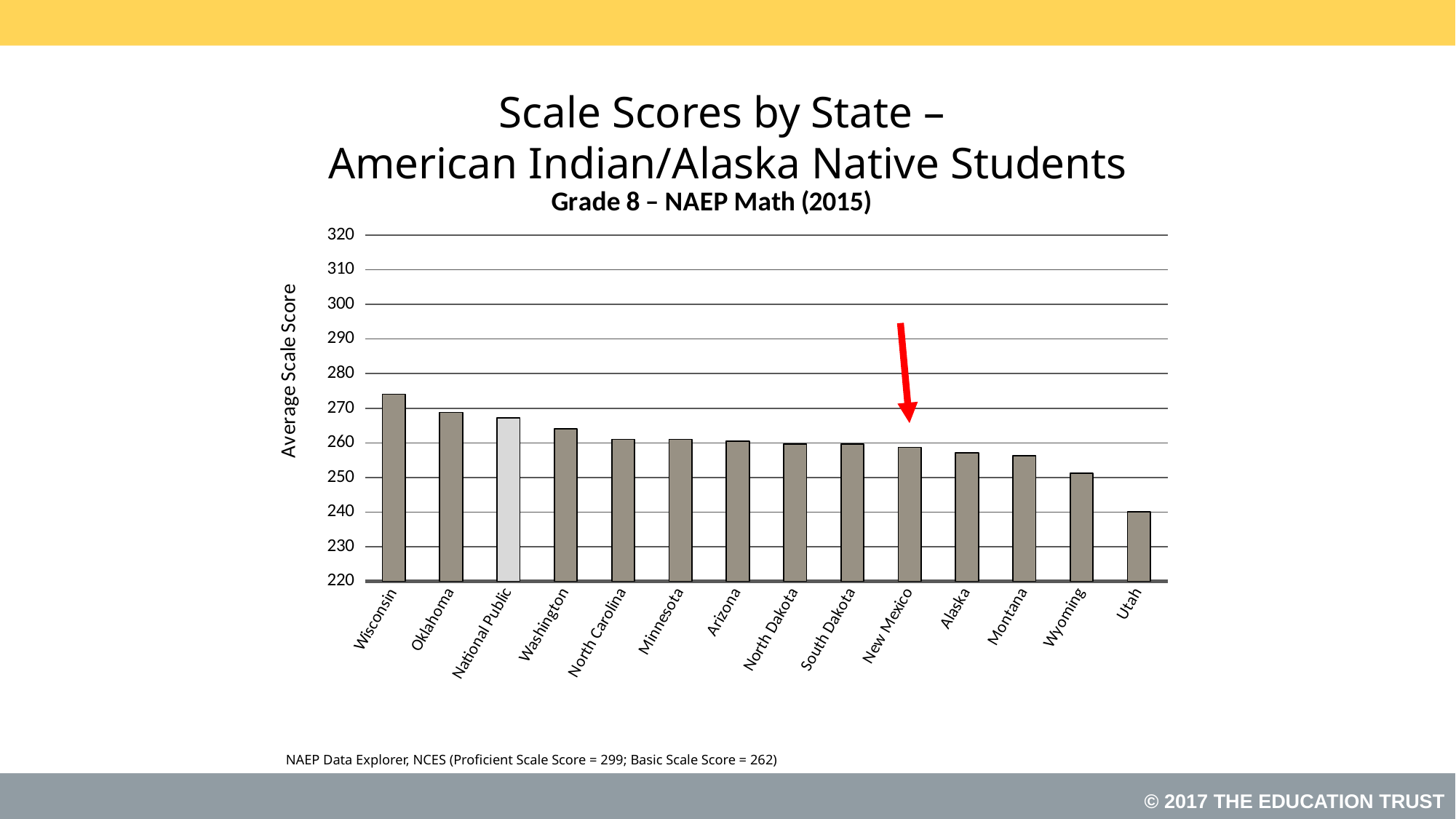
Do the values rise or fall moving from left to right along the x axis? fall Is the value for Washington greater or less than 260? greater Is the value for Wyoming greater or less than 260? less Which has a higher average scale score, Oklahoma or Wyoming? Oklahoma How many bars are plotted in the chart? 14 Which state has the highest average scale score? Wisconsin What is the title of the vertical axis? Average Scale Score Which bar does the red arrow point to? New Mexico What kind of chart is shown on the slide? bar chart Which state has the lowest average scale score? Utah Is the value for Wisconsin greater or less than 270? greater